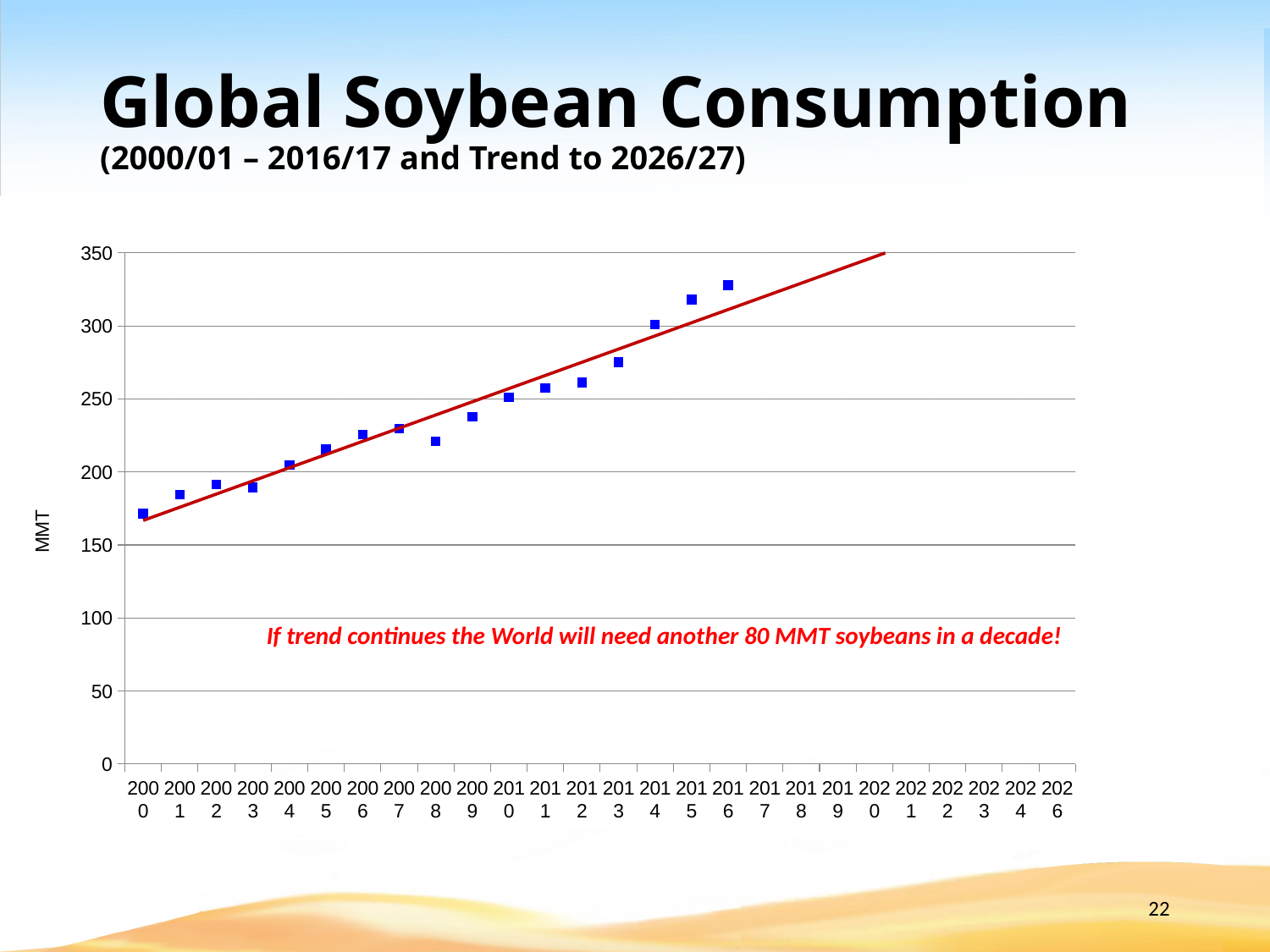
Is the value for 2013 greater or less than 250? greater Which year has the highest plotted soybean consumption value? 2016 Is the value for 2016 greater or less than 300? greater What kind of chart is shown on the slide? scatter chart Do the plotted soybean consumption values generally rise or fall from 2000 to 2016? rise Is the value for 2000 greater or less than 150? greater What is the title of the chart on the slide? Global Soybean Consumption How many data points are plotted on the chart? 17 Which is larger, the value for 2008 or the value for 2009? 2009 What is the label on the vertical axis of the chart? MMT Which year has the lowest plotted soybean consumption value? 2000